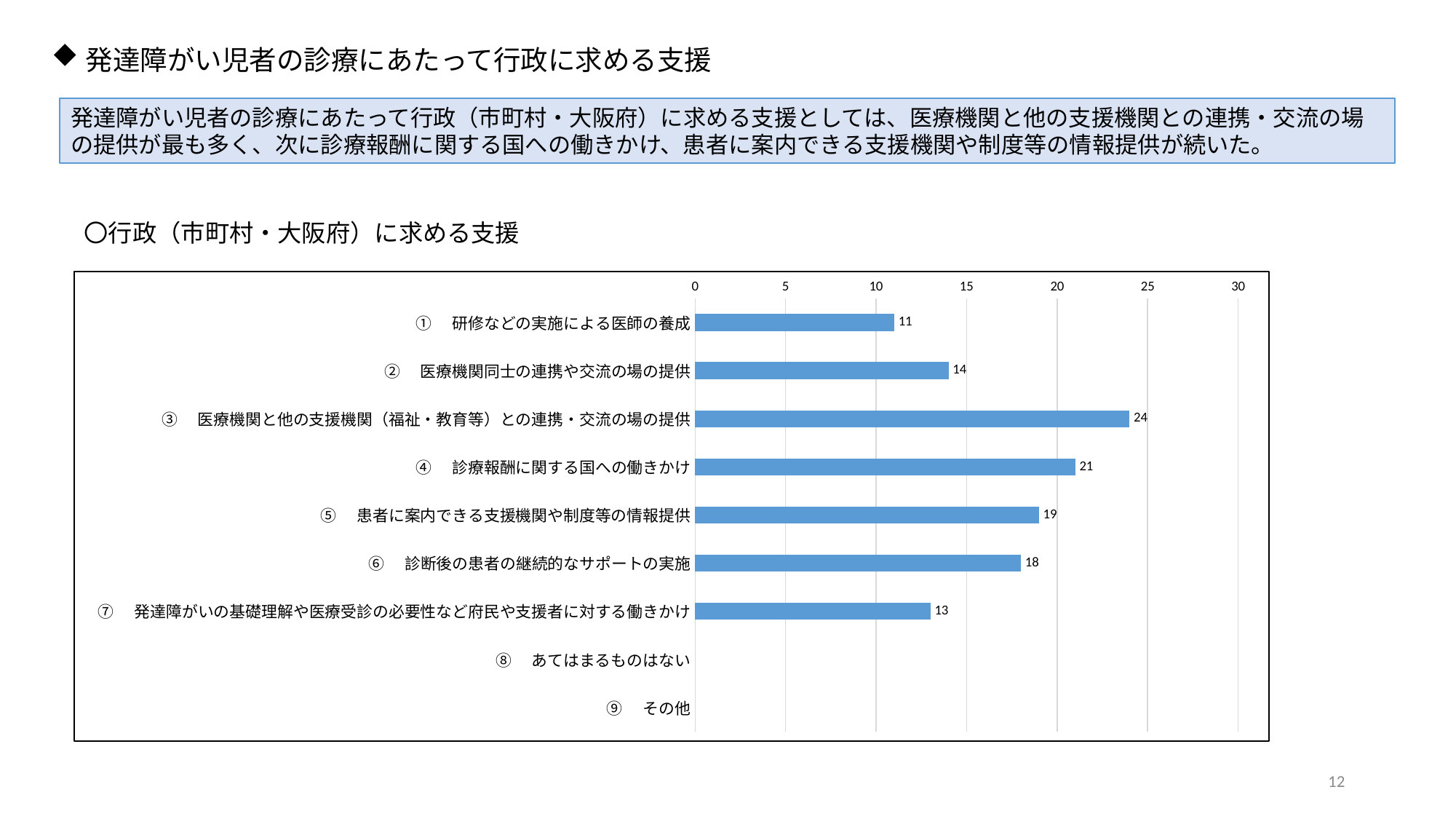
What is the difference between the values for ④ 診療報酬に関する国への働きかけ and ⑤ 患者に案内できる支援機関や制度等の情報提供? 2 Among the categories with a visible bar, which has the lowest value? ① 研修などの実施による医師の養成 What is the value for ⑥ 診断後の患者の継続的なサポートの実施? 18 What is the maximum value shown on the value axis? 30 How many categories are listed on the chart? 9 What is the title of the chart? 行政（市町村・大阪府）に求める支援 Which category has the highest value? ③ 医療機関と他の支援機関（福祉・教育等）との連携・交流の場の提供 Is the value for ④ 診療報酬に関する国への働きかけ greater or less than 20? greater What is the value for ① 研修などの実施による医師の養成? 11 What is the value for ③ 医療機関と他の支援機関（福祉・教育等）との連携・交流の場の提供? 24 Which is larger, the value for ② 医療機関同士の連携や交流の場の提供 or the value for ⑦ 発達障がいの基礎理解や医療受診の必要性など府民や支援者に対する働きかけ? ② 医療機関同士の連携や交流の場の提供 What kind of chart is shown on the slide? Bar chart